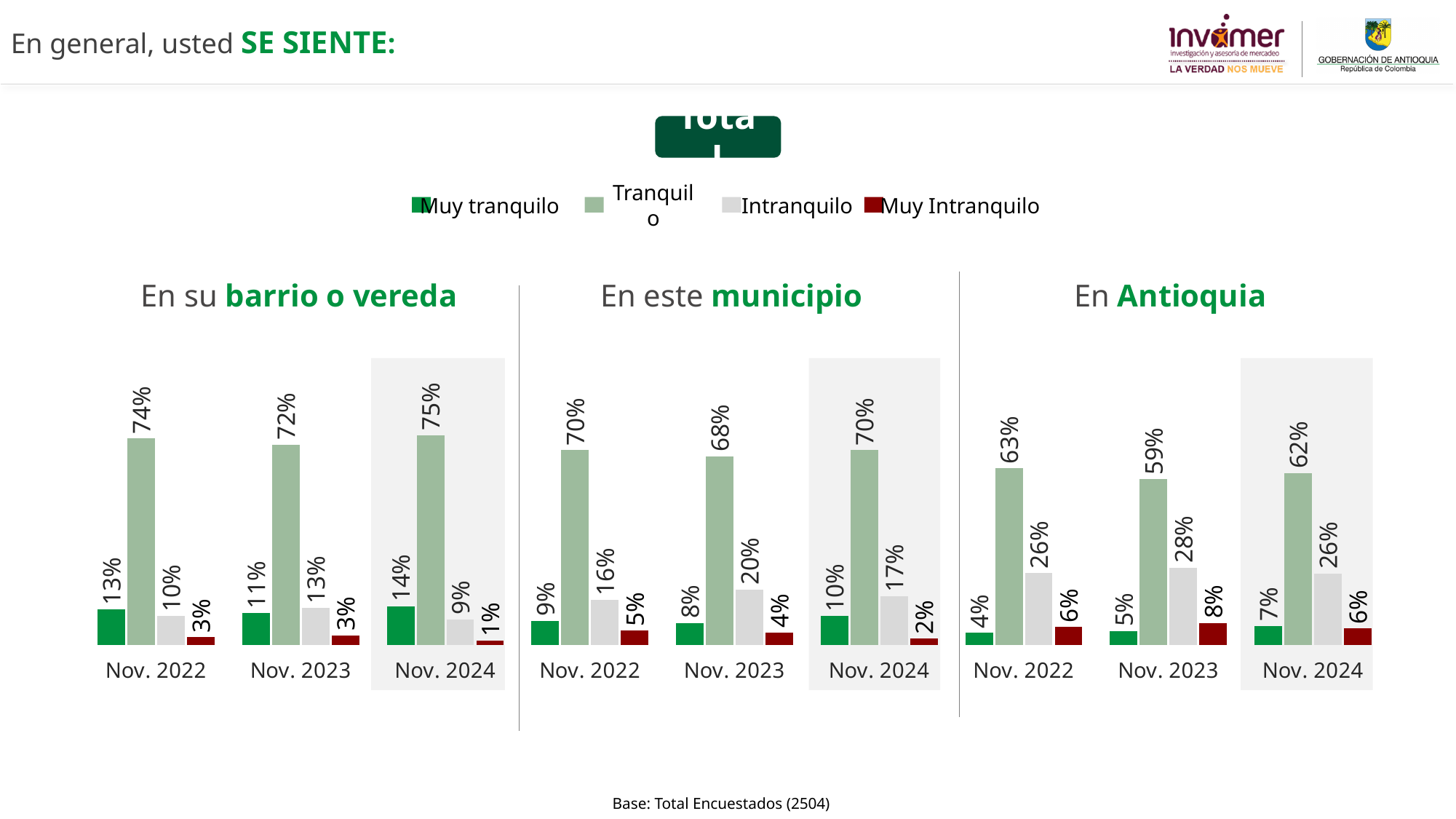
In the 'En su barrio o vereda' chart, which period has the lowest value for Muy Intranquilo? Nov. 2024 How many series does the legend list? 4 In the 'En Antioquia' chart, which is larger in Nov. 2024: Muy tranquilo or Muy Intranquilo? Muy tranquilo In the 'En este municipio' chart, what is the value for Intranquilo in Nov. 2023? 20% In the 'En Antioquia' chart, what is the value for Muy Intranquilo in Nov. 2023? 8% In the 'En este municipio' chart, what is the difference between the Tranquilo values for Nov. 2022 and Nov. 2023? 2% In the 'En su barrio o vereda' chart, what is the value for Tranquilo in Nov. 2024? 75% What kind of chart is used for 'En su barrio o vereda'? Bar chart In the 'En Antioquia' chart, does the Muy tranquilo value rise or fall from Nov. 2022 to Nov. 2024? Rise Which legend entry is shown in dark red? Muy Intranquilo In the 'En Antioquia' chart, which period has the highest value for Tranquilo? Nov. 2022 How many periods are shown on the x axis of the 'En este municipio' chart? 3